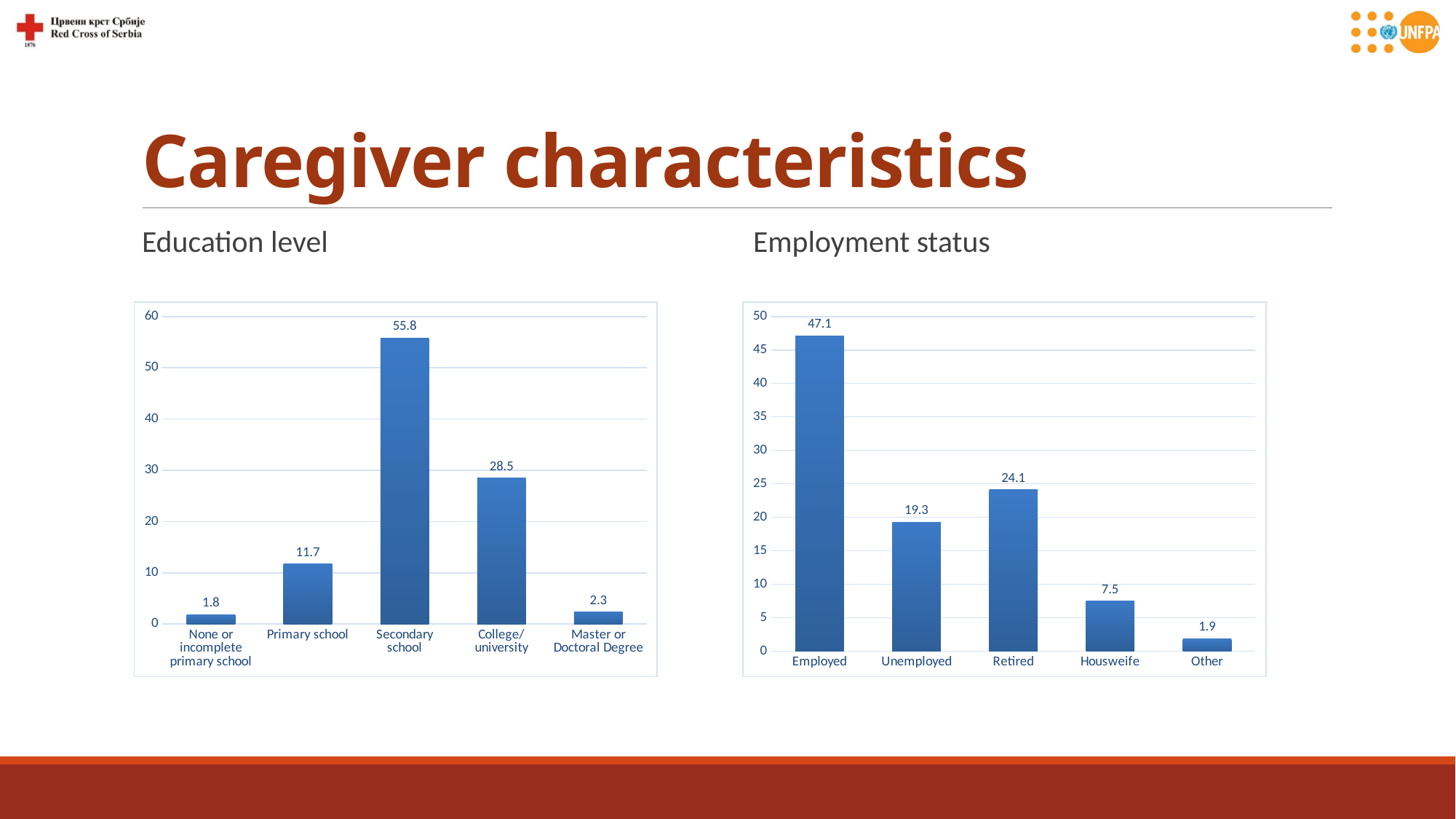
In the Employment status chart, what is the value for Retired? 24.1 In the Education level chart, which is larger: Master or Doctoral Degree or None or incomplete primary school? Master or Doctoral Degree What type of chart is the Employment status chart? Bar chart In the Education level chart, what is the value for Primary school? 11.7 In the Education level chart, how many categories are shown? 5 In the Education level chart, what is the value for Secondary school? 55.8 In the Employment status chart, which category has the highest value? Employed In the Employment status chart, which category has the lowest value? Other In the Employment status chart, what is the difference between Employed and Unemployed? 27.8 In the Education level chart, which category has the lowest value? None or incomplete primary school In the Employment status chart, what is the value for Houswefie? 7.5 In the Education level chart, what is the difference between Secondary school and College/university? 27.3